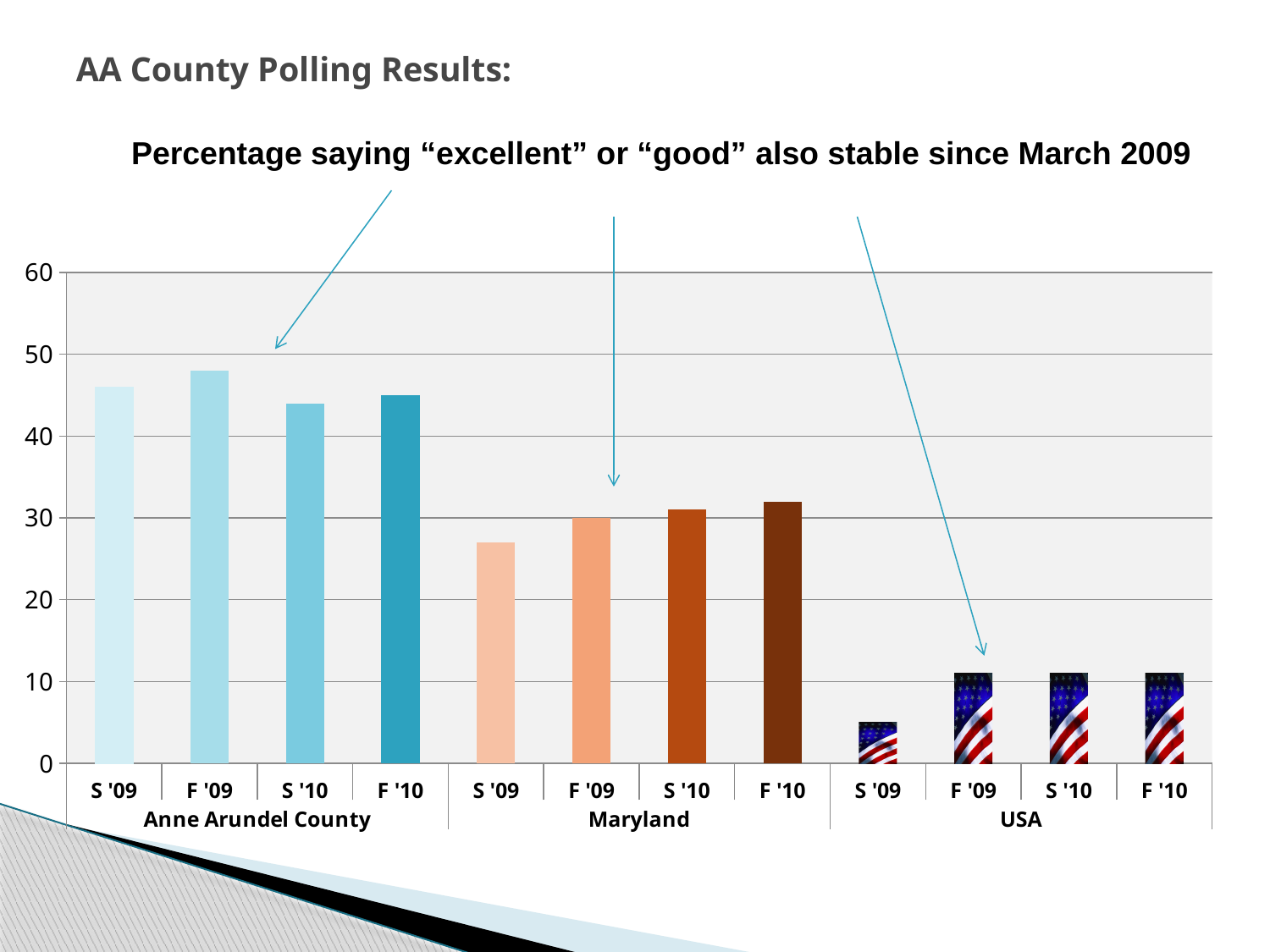
What kind of chart is shown on the slide? bar chart Do the Maryland values rise or fall from S '09 to F '10? rise How many groups (regions) are labelled along the x axis? 3 Which bar is the tallest in the chart? F '09 for Anne Arundel County Which bar is the shortest in the chart? S '09 for USA Is the value for S '09 in USA greater or less than 10? less Is the value for S '09 in Maryland greater or less than 30? less Is the value for F '09 in Anne Arundel County greater or less than 50? less How many bars are plotted in the chart? 12 Which is larger, the F '10 value for Anne Arundel County or the F '10 value for Maryland? Anne Arundel County What are the three regions labelled along the x axis? Anne Arundel County, Maryland, USA